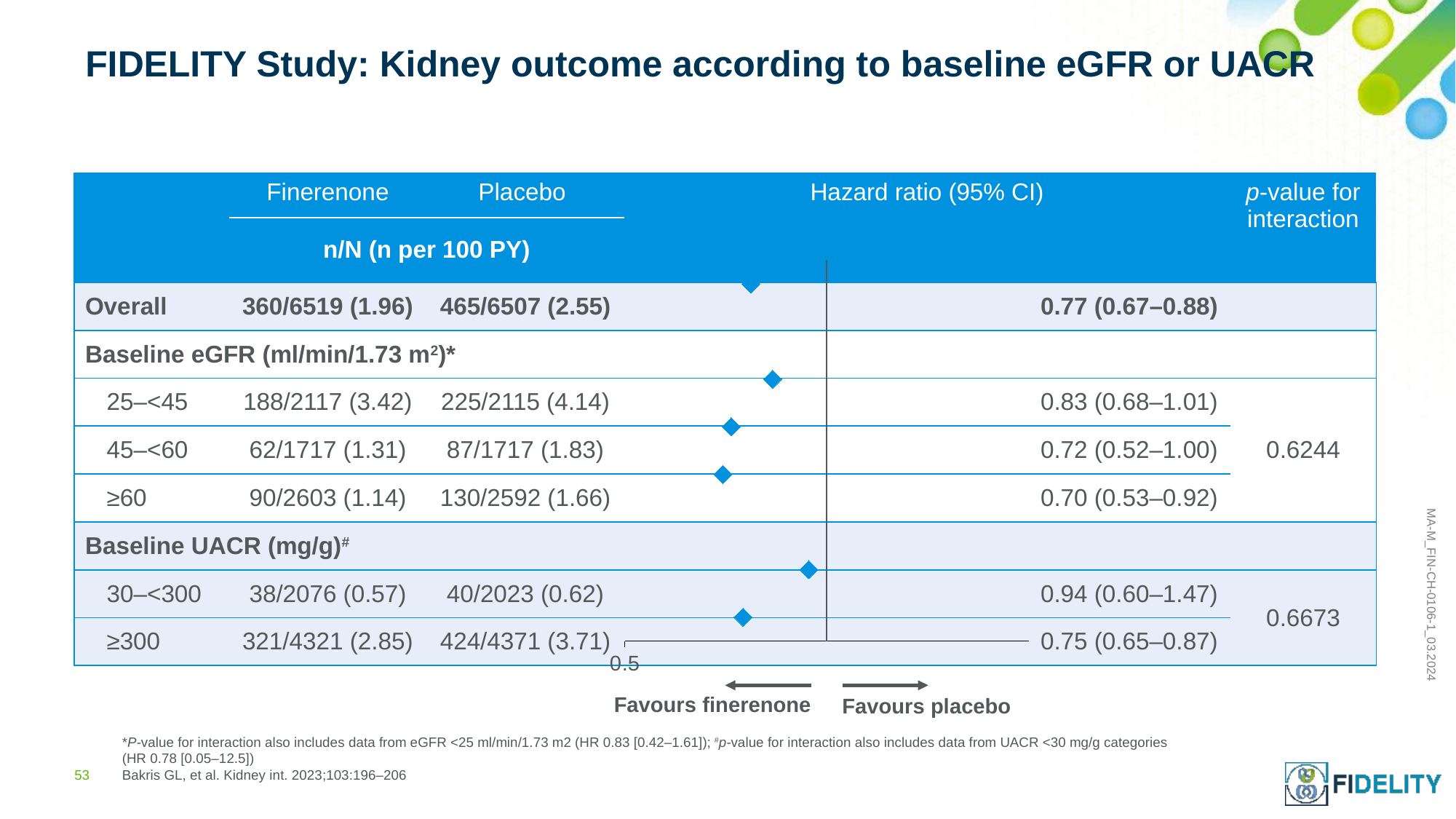
How many hazard ratio points are plotted in the forest plot? 6 What is the difference between the hazard ratio for UACR 30–<300 and the hazard ratio for eGFR ≥60? 0.24 What is the overall hazard ratio (95% CI)? 0.77 (0.67–0.88) Which subgroup has the highest hazard ratio? UACR 30–<300 Is the hazard ratio for UACR ≥300 greater or less than 0.5? greater What is the hazard ratio (95% CI) for the baseline UACR 30–<300 mg/g subgroup? 0.94 (0.60–1.47) What is the hazard ratio (95% CI) for the baseline eGFR ≥60 subgroup? 0.70 (0.53–0.92) Which subgroup has the lowest hazard ratio? eGFR ≥60 What is the p-value for interaction for the baseline eGFR subgroups? 0.6244 Which has the larger hazard ratio, eGFR 25–<45 or eGFR 45–<60? eGFR 25–<45 What kind of chart is shown on the slide? Forest plot What does the arrow pointing left below the plot indicate? Favours finerenone